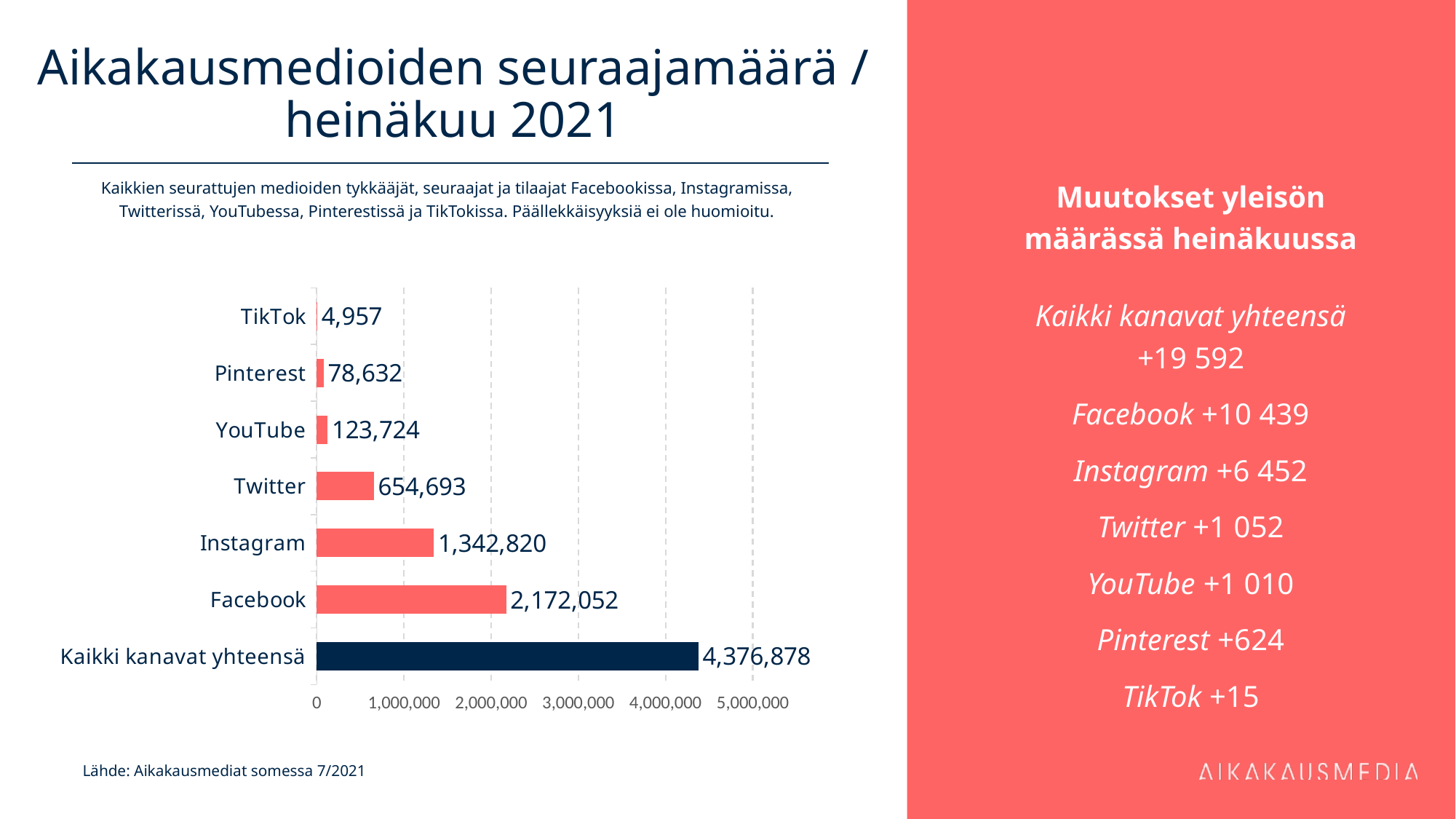
What is the value shown for Facebook? 2,172,052 Which category has the lowest value in the chart? TikTok What is the value shown for Kaikki kanavat yhteensä? 4,376,878 What is the difference between the values for Facebook and Instagram? 829,232 What is the value shown for TikTok? 4,957 How many categories are shown in the chart? 7 Is the value for Facebook greater or less than 2,000,000? greater Which is larger, the value for Instagram or the value for Twitter? Instagram What kind of chart is shown on the slide? Bar chart What is the value shown for Instagram? 1,342,820 Which individual platform (excluding the total bar) has the highest value? Facebook What is the difference between the values for Twitter and YouTube? 530,969